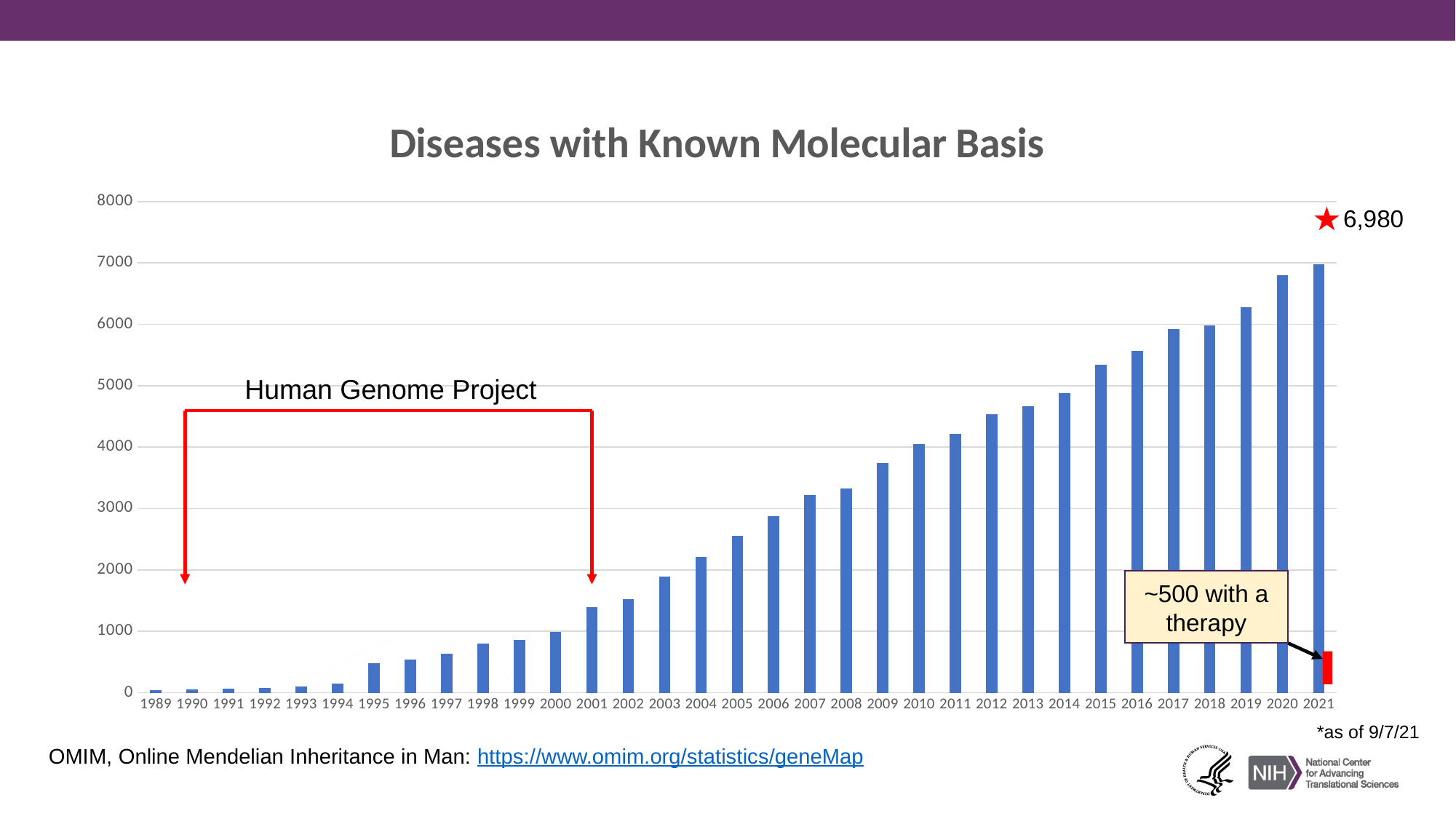
Is the value for 2009 greater or less than 4000? less Which year has the larger value, 2008 or 2013? 2013 What is the title of the chart? Diseases with Known Molecular Basis What value is labelled for 2021 on the chart? 6,980 Is the value for 2020 greater or less than 7000? less Do the values generally rise or fall from 1989 to 2021? rise How many years are shown along the x axis? 33 Which year has the highest bar on the chart? 2021 What kind of chart is shown on the slide? bar chart Which years does the 'Human Genome Project' annotation span on the chart? 1990 to 2001 Is the value for 2001 greater or less than 1000? greater